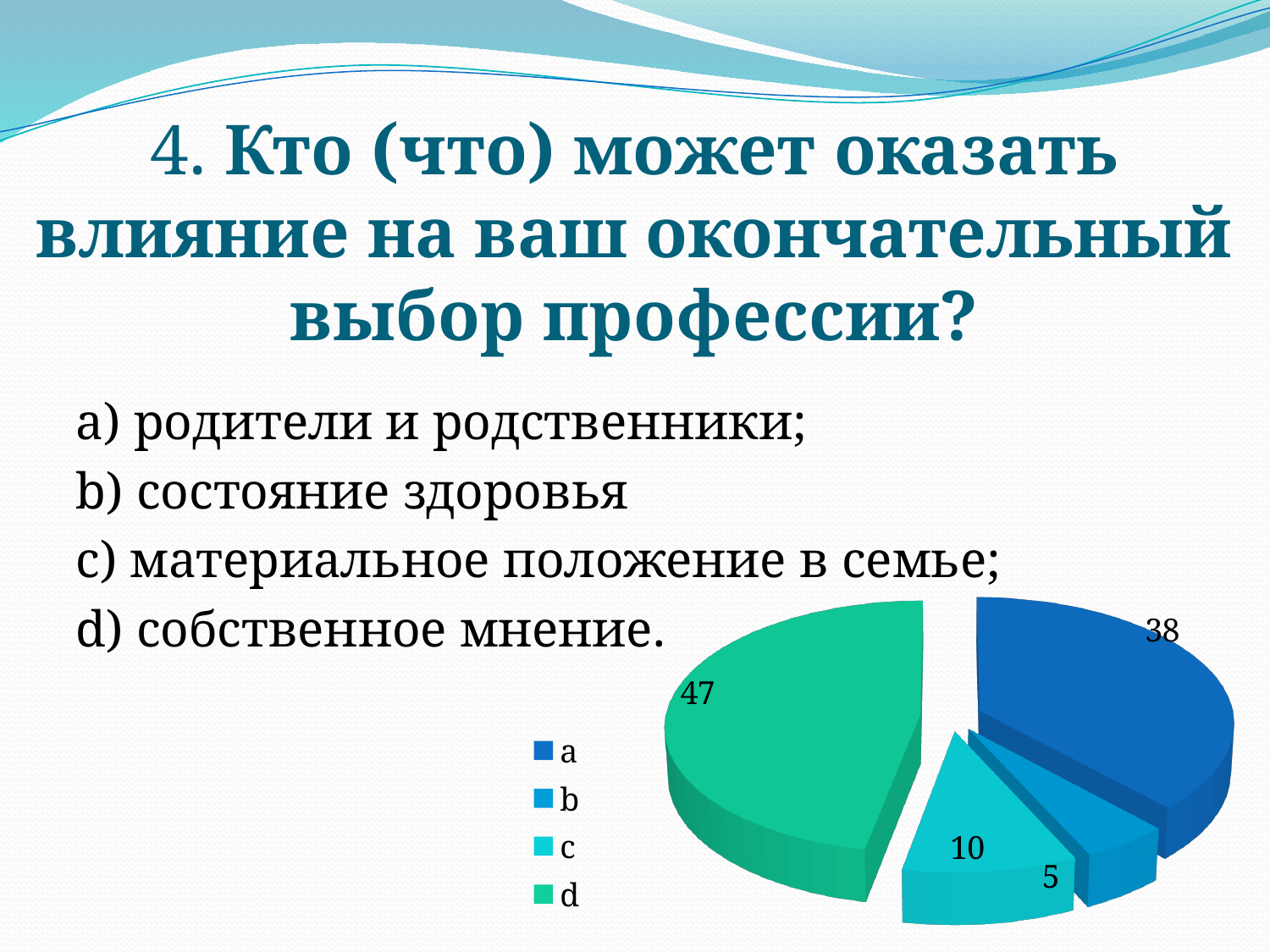
What is the value for slice a in the pie chart? 38 What colour is slice d in the pie chart? green What is the total of all the values shown in the pie chart? 100 Which slice of the pie chart is the smallest? b Which slice of the pie chart is the largest? d What kind of chart is shown on the slide? pie chart How many slices does the pie chart have? 4 Which is larger, the value for slice c or the value for slice b? c What is the value for slice d in the pie chart? 47 What is the value for slice b in the pie chart? 5 What is the value for slice c in the pie chart? 10 What is the difference between the values for slices d and a? 9